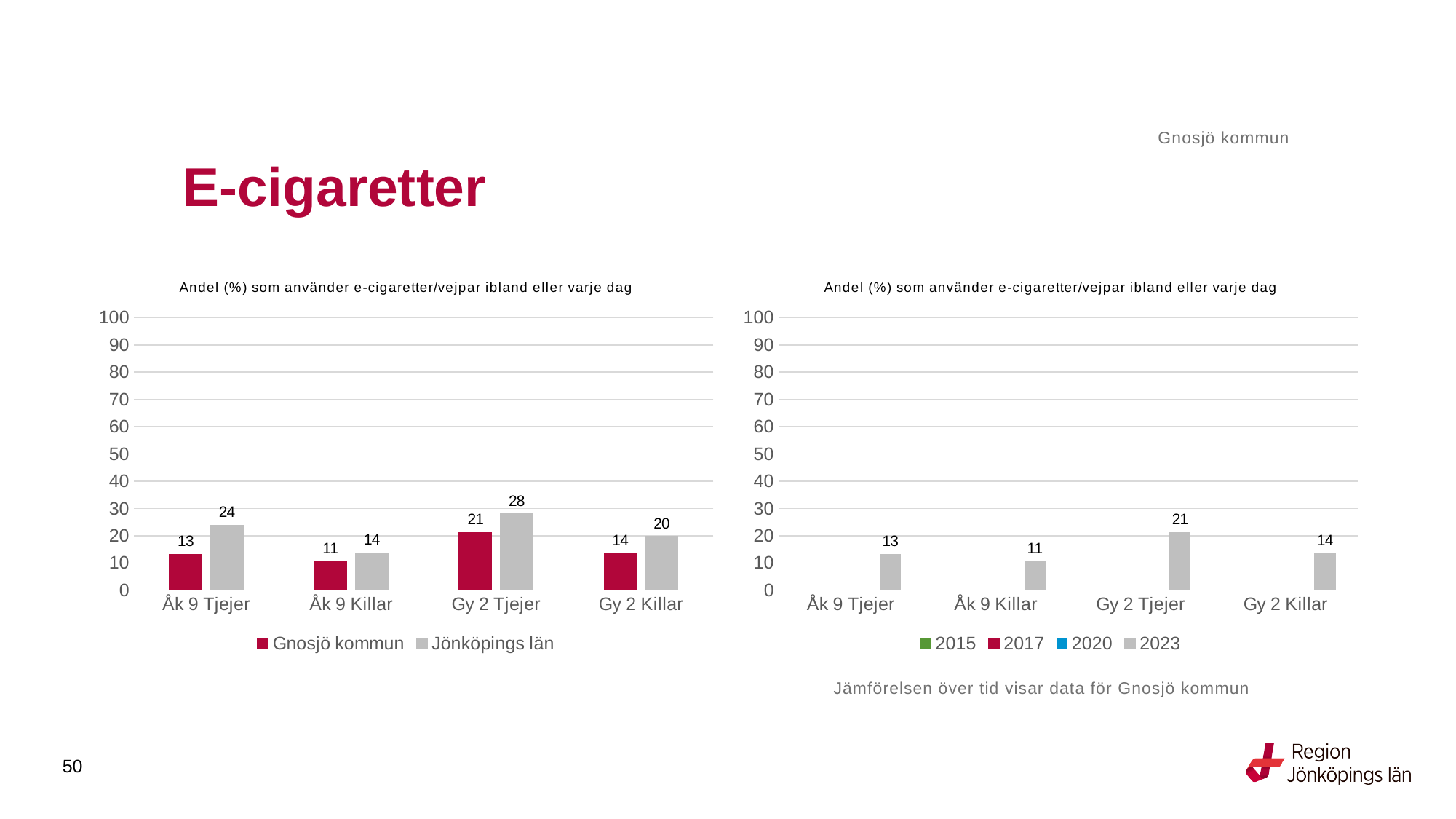
What kind of chart is the right chart? Bar chart In the left chart, how many series does the legend list? 2 In the left chart, which category has the lowest value for Gnosjö kommun? Åk 9 Killar In the right chart, how many series does the legend list? 4 In the right chart, what is the 2023 value for Gy 2 Killar? 14 In the right chart, how many categories are shown on the x axis? 4 In the right chart, is the 2023 value for Gy 2 Tjejer greater or less than 30? less In the left chart, what is the value for Gnosjö kommun for Gy 2 Tjejer? 21 In the left chart, which category has the highest value for Jönköpings län? Gy 2 Tjejer In the left chart, what is the value for Jönköpings län for Åk 9 Killar? 14 In the left chart, which is larger for Gy 2 Killar: Gnosjö kommun or Jönköpings län? Jönköpings län In the left chart, what is the difference between Jönköpings län and Gnosjö kommun for Åk 9 Tjejer? 11